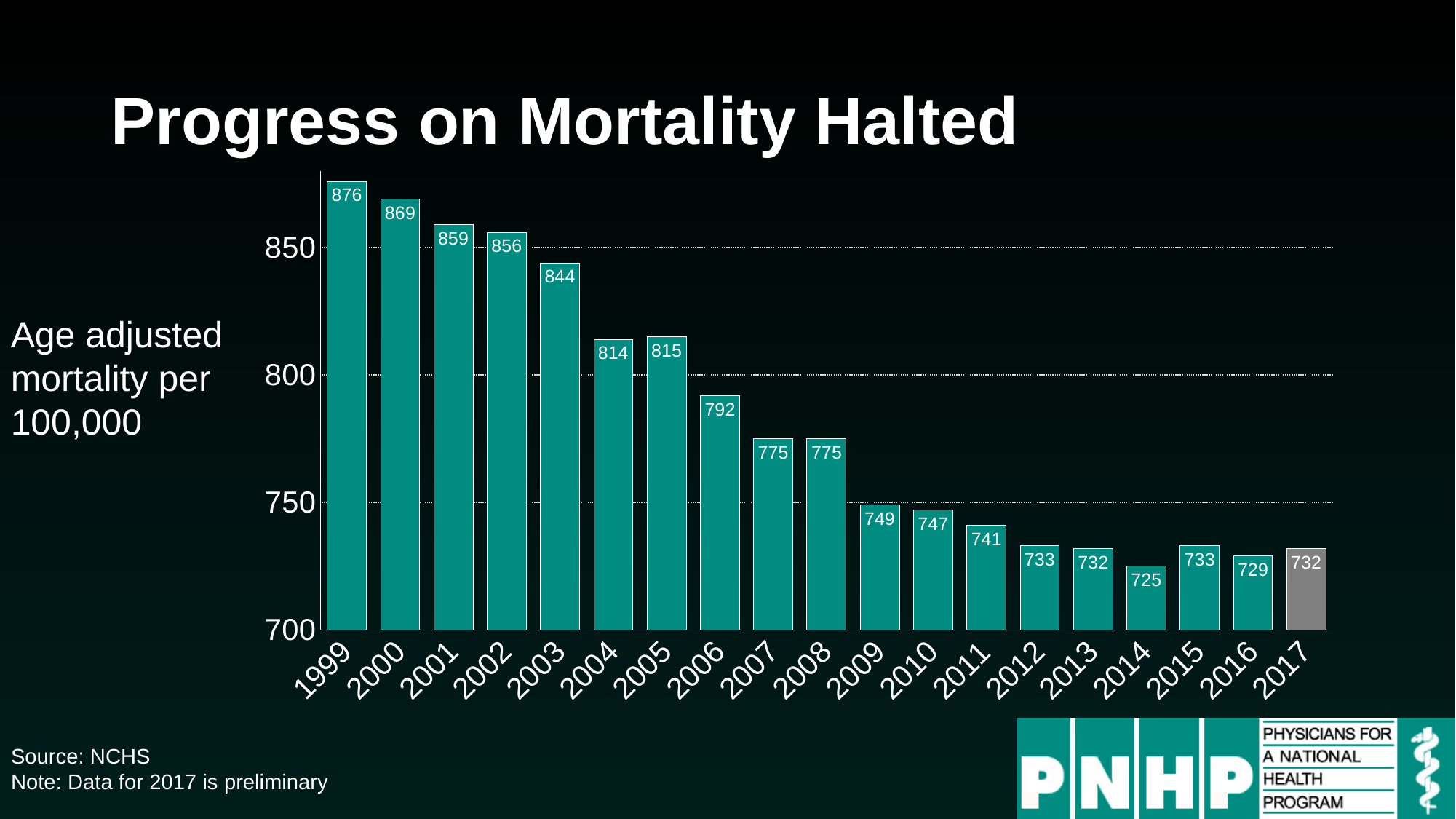
Do the values generally rise or fall from 1999 to 2017? fall What is the age adjusted mortality per 100,000 for 2017? 732 What is the difference in age adjusted mortality between 1999 and 2017? 144 How many years are shown on the x axis? 19 Which year has the highest age adjusted mortality? 1999 Is the value for 2008 greater or less than 800? less Which year has the lowest age adjusted mortality? 2014 What kind of chart is shown on the slide? bar chart What is the age adjusted mortality per 100,000 for 1999? 876 What is the age adjusted mortality per 100,000 for 2014? 725 What is the difference in age adjusted mortality between 2003 and 2004? 30 Which year has a higher age adjusted mortality, 2006 or 2009? 2006